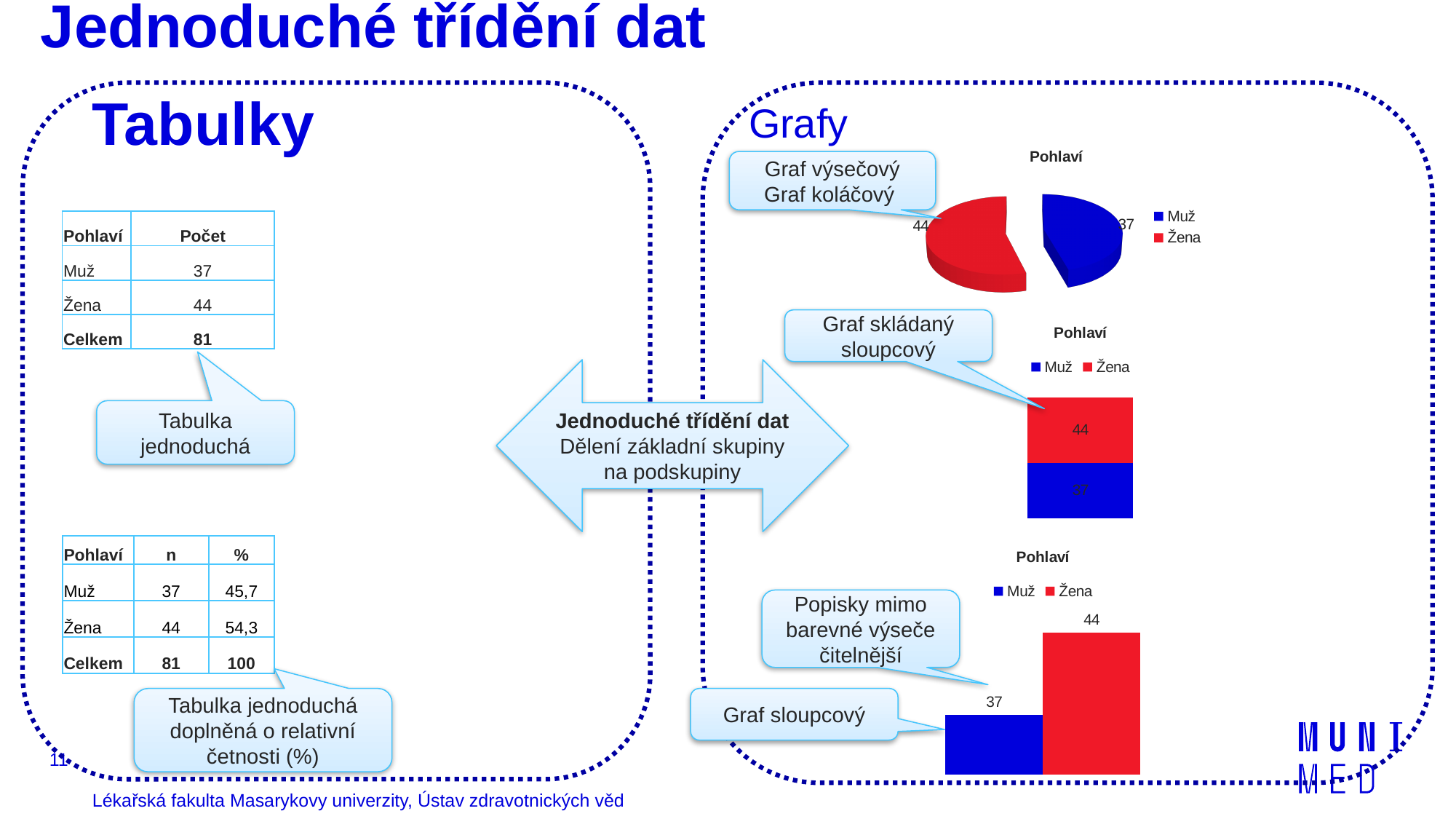
How many series does the legend of the middle stacked bar chart list? 2 In the middle stacked bar chart, what is the total of the stacked bar? 81 What kind of chart is the top chart on the right side of the slide? pie chart In the bottom bar chart, what is the difference between the values for Žena and Muž? 7 In the top pie chart, what is the value for Žena? 44 In the top pie chart, what is the value for Muž? 37 In the middle stacked bar chart, what is the value of the Muž segment? 37 What kind of chart is the bottom chart on the right side of the slide? bar chart What is the title of the bottom bar chart? Pohlaví In the top pie chart, which slice is larger, Muž or Žena? Žena In the bottom bar chart, which category has the highest value? Žena In the bottom bar chart, which category has the lowest value? Muž